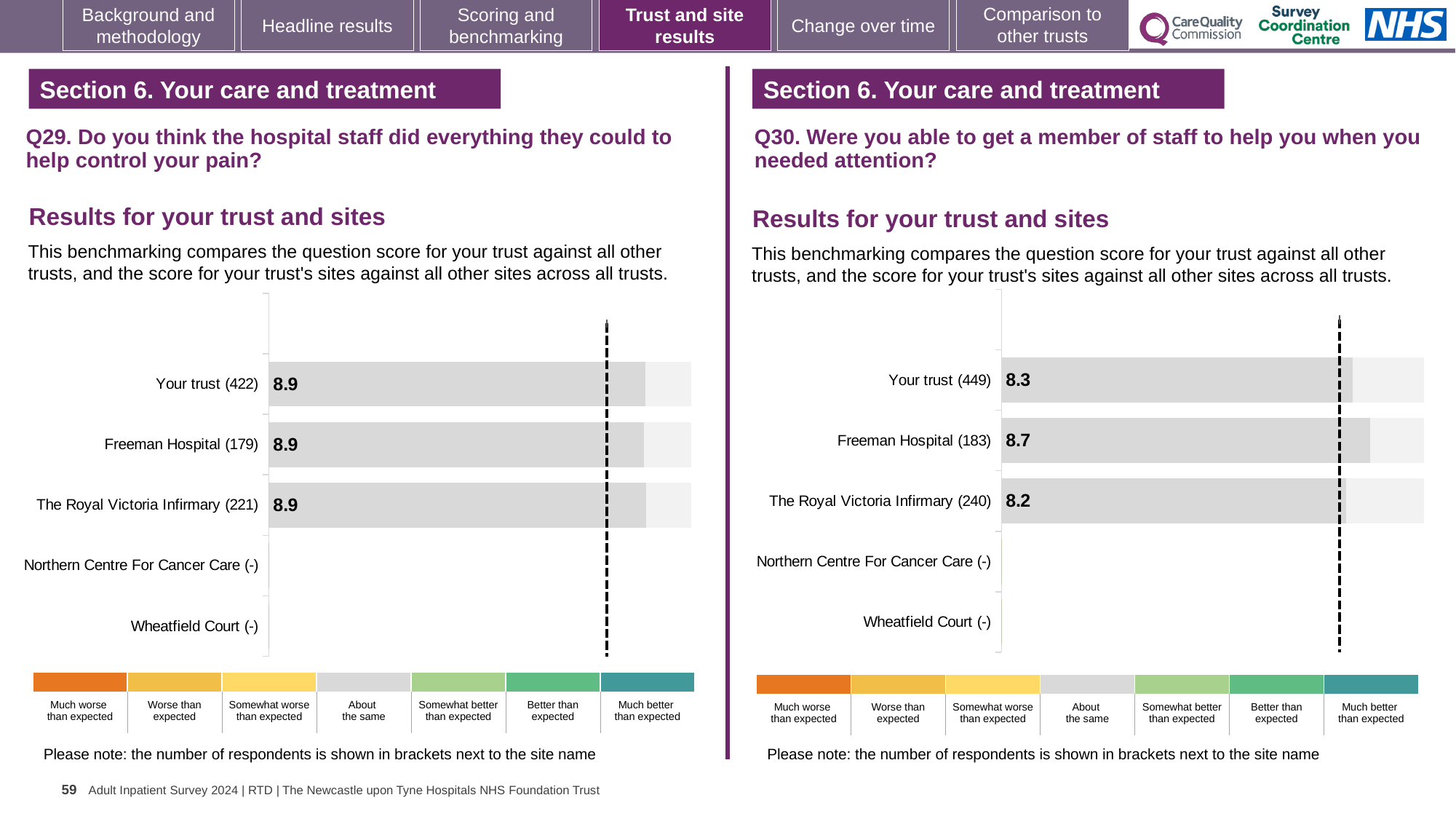
What kind of chart is used on the Q29 chart (left)? Bar chart On the Q30 chart (right), which has the larger score, Your trust or Freeman Hospital? Freeman Hospital On the Q30 chart (right), what is the score for Your trust? 8.3 On the Q30 chart (right), what is the difference between the Freeman Hospital score and The Royal Victoria Infirmary score? 0.5 On the Q29 chart (left), what is the score for Your trust? 8.9 On the Q29 chart (left), how many site or trust rows are listed on the vertical axis? 5 On the Q29 chart (left), how many respondents are shown in brackets for The Royal Victoria Infirmary? 221 On the Q30 chart (right), what is the score for The Royal Victoria Infirmary? 8.2 On the Q30 chart (right), how many respondents are shown in brackets for Your trust? 449 On the Q30 chart (right), what is the score for Freeman Hospital? 8.7 On the Q30 chart (right), which site or trust row has the highest score? Freeman Hospital On the Q30 chart (right), which site or trust row has the lowest score? The Royal Victoria Infirmary